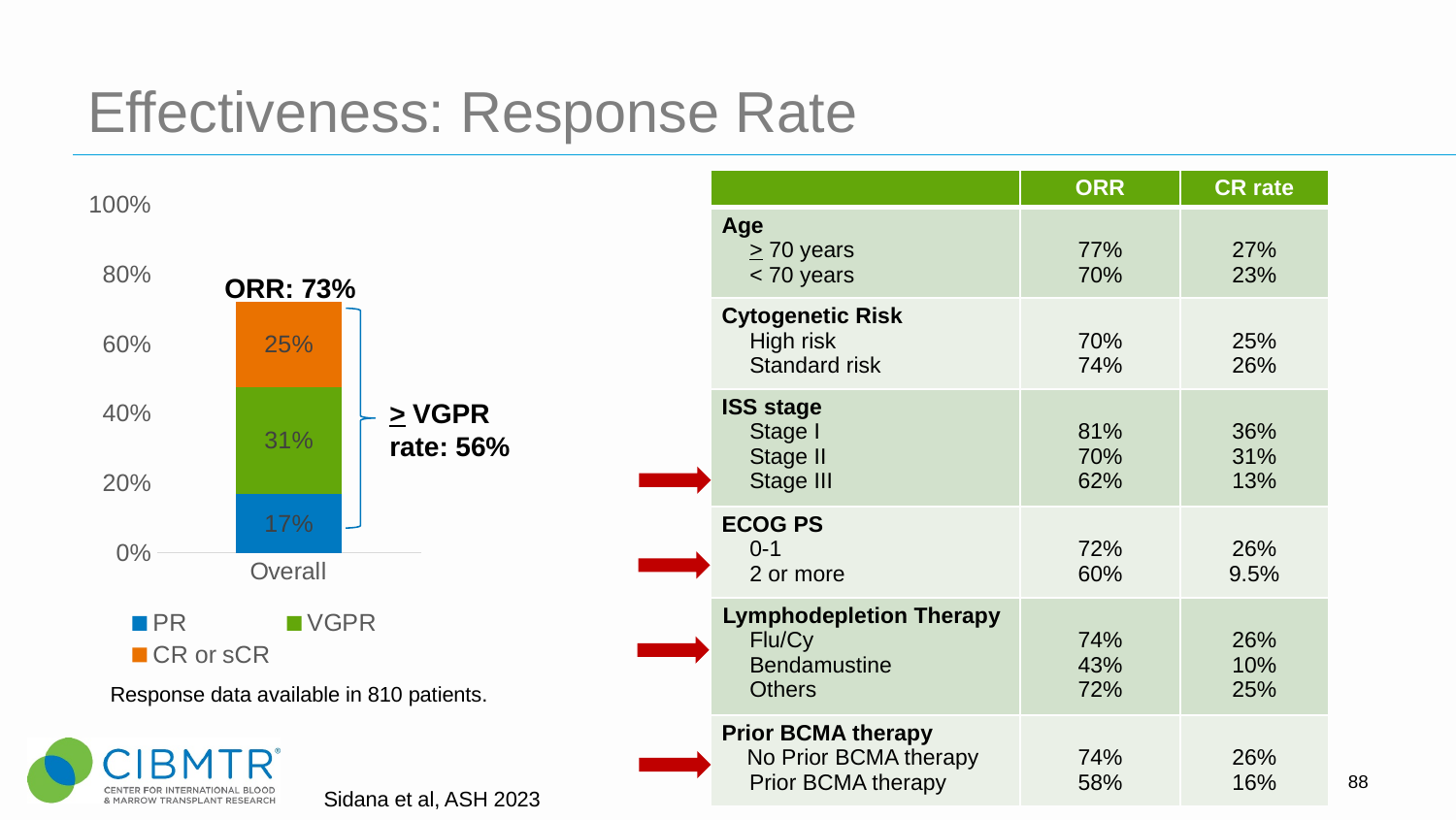
How many series does the legend list? 3 Which is larger in the Overall bar, the CR or sCR segment or the PR segment? CR or sCR What is the total of the stacked Overall bar? 73% What is the value of the PR segment in the Overall bar? 17% Which series has the largest segment in the Overall bar? VGPR What kind of chart is shown on the slide? Stacked bar chart What is the difference between the VGPR and PR segments in the Overall bar? 14% What colour is the VGPR series in the chart? Green How many categories are shown on the x axis of the chart? 1 Which series has the smallest segment in the Overall bar? PR What is the value of the CR or sCR segment in the Overall bar? 25% What is the value of the VGPR segment in the Overall bar? 31%